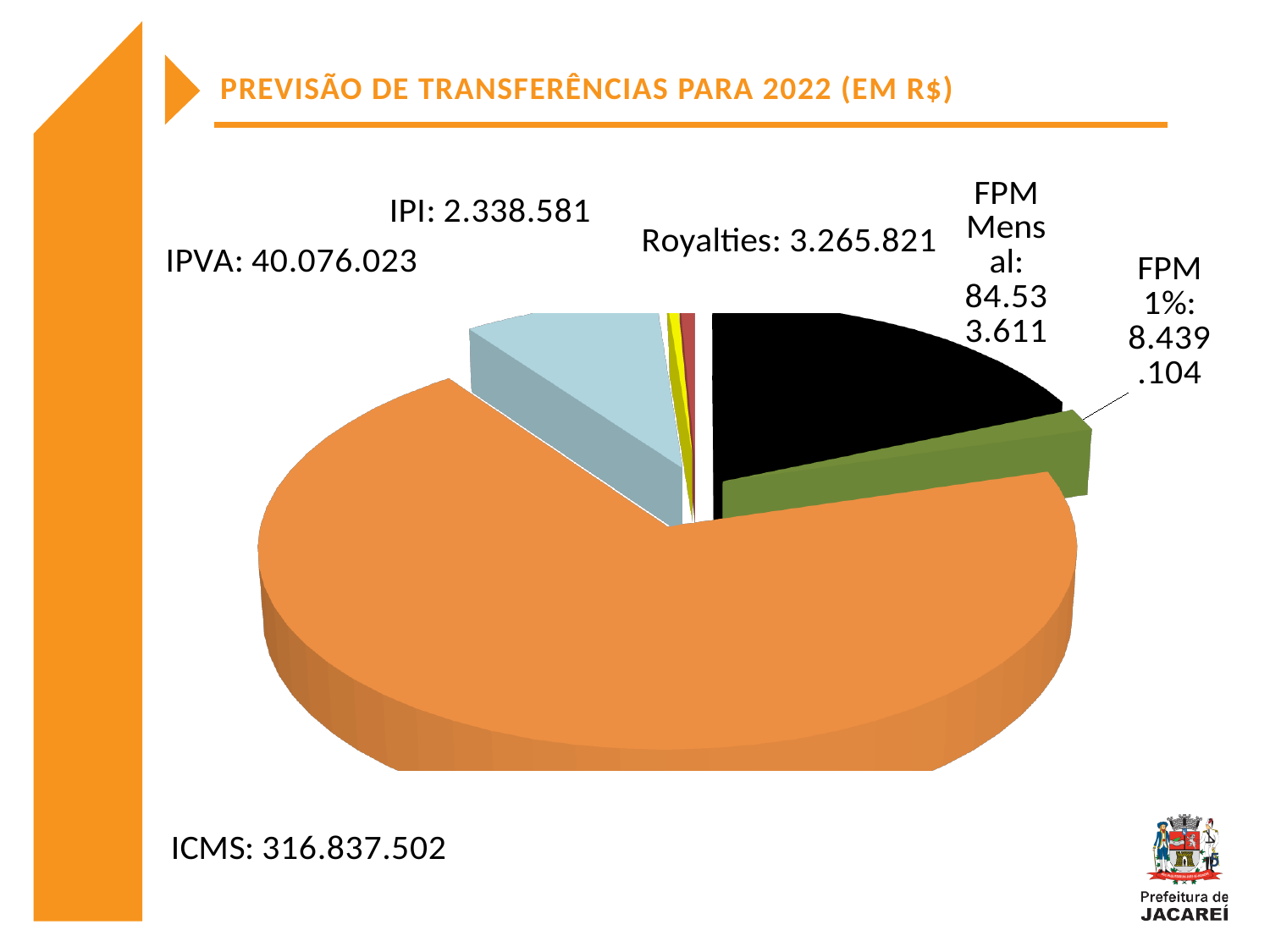
Which is larger, Royalties or IPI? Royalties What is the value for Royalties? 3.265.821 What is the title of the chart? PREVISÃO DE TRANSFERÊNCIAS PARA 2022 (EM R$) What is the difference between the values for FPM Mensal and FPM 1%? 76.094.507 What is the value for IPVA? 40.076.023 What is the difference between the values for ICMS and IPVA? 276.761.479 How many slices does the pie chart have? 6 What kind of chart is shown on the slide? Pie chart What is the value for FPM Mensal? 84.533.611 Which category has the lowest value? IPI Which category has the highest value? ICMS What is the value for ICMS? 316.837.502